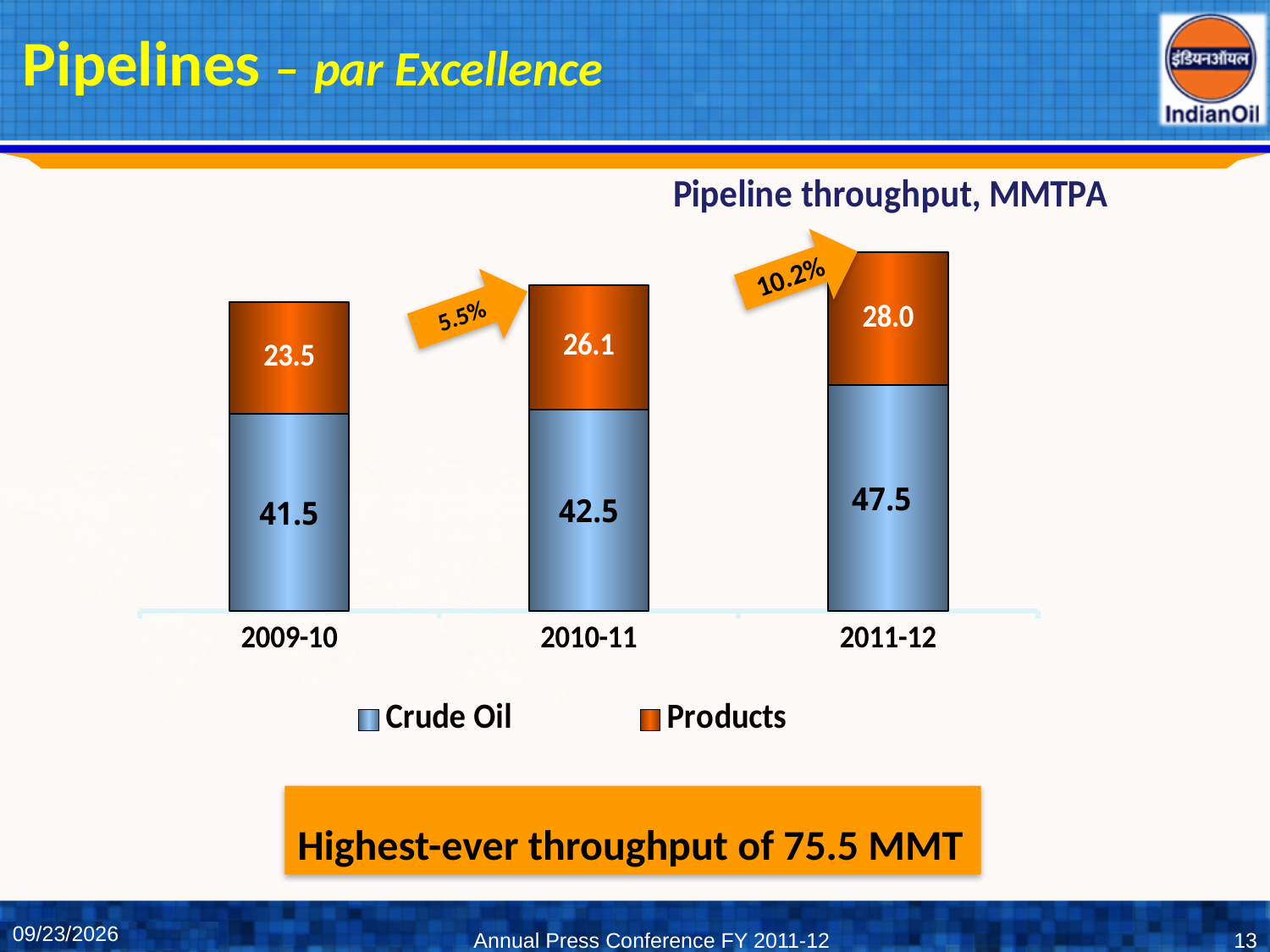
What is the Crude Oil value for 2011-12? 47.5 What is the Products value for 2009-10? 23.5 Do the Crude Oil values rise or fall from 2009-10 to 2011-12? Rise What kind of chart is shown? Stacked bar chart What is the difference between the Crude Oil values for 2011-12 and 2010-11? 5.0 Which year has the highest Crude Oil value? 2011-12 What is the total of the stacked bar for 2011-12? 75.5 Which year has the lowest Products value? 2009-10 How many years are shown on the x axis? 3 How many series does the legend list? 2 What is the Products value for 2010-11? 26.1 Which is larger, the Products value for 2010-11 or for 2011-12? 2011-12